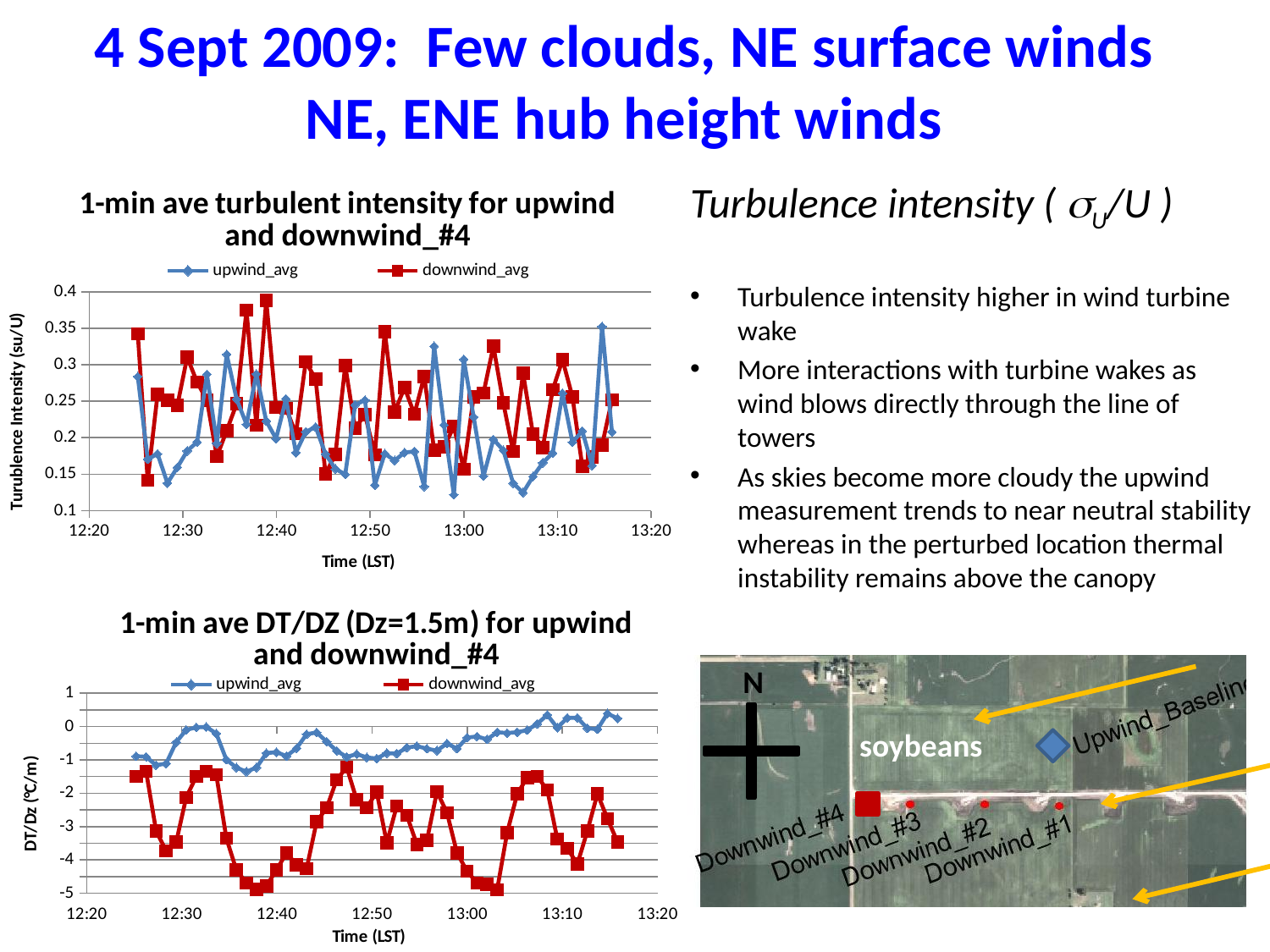
In the bottom chart (DT/DZ), which series reaches the lowest value? downwind_avg What are the two series named in the legend of the bottom chart (DT/DZ)? upwind_avg and downwind_avg In the bottom chart (DT/DZ), is the upwind_avg value near 12:37 greater or less than -2? greater In the bottom chart (DT/DZ), is the downwind_avg value near 12:37 greater or less than -4? less In the top chart (turbulent intensity), is the peak value of downwind_avg near 12:39 greater or less than 0.35? greater In the top chart (turbulent intensity), which series has the larger value at about 12:39, upwind_avg or downwind_avg? downwind_avg In the bottom chart (DT/DZ), which series has the larger value at 13:00, upwind_avg or downwind_avg? upwind_avg In the bottom chart (DT/DZ), does the upwind_avg series generally rise or fall from 12:25 to 13:16? rise What is the y-axis title of the bottom chart titled '1-min ave DT/DZ (Dz=1.5m) for upwind and downwind_#4'? DT/Dz (°C/m) How many series does the legend of the top chart (turbulent intensity) list? 2 What type of chart is the top chart titled '1-min ave turbulent intensity for upwind and downwind_#4'? line chart